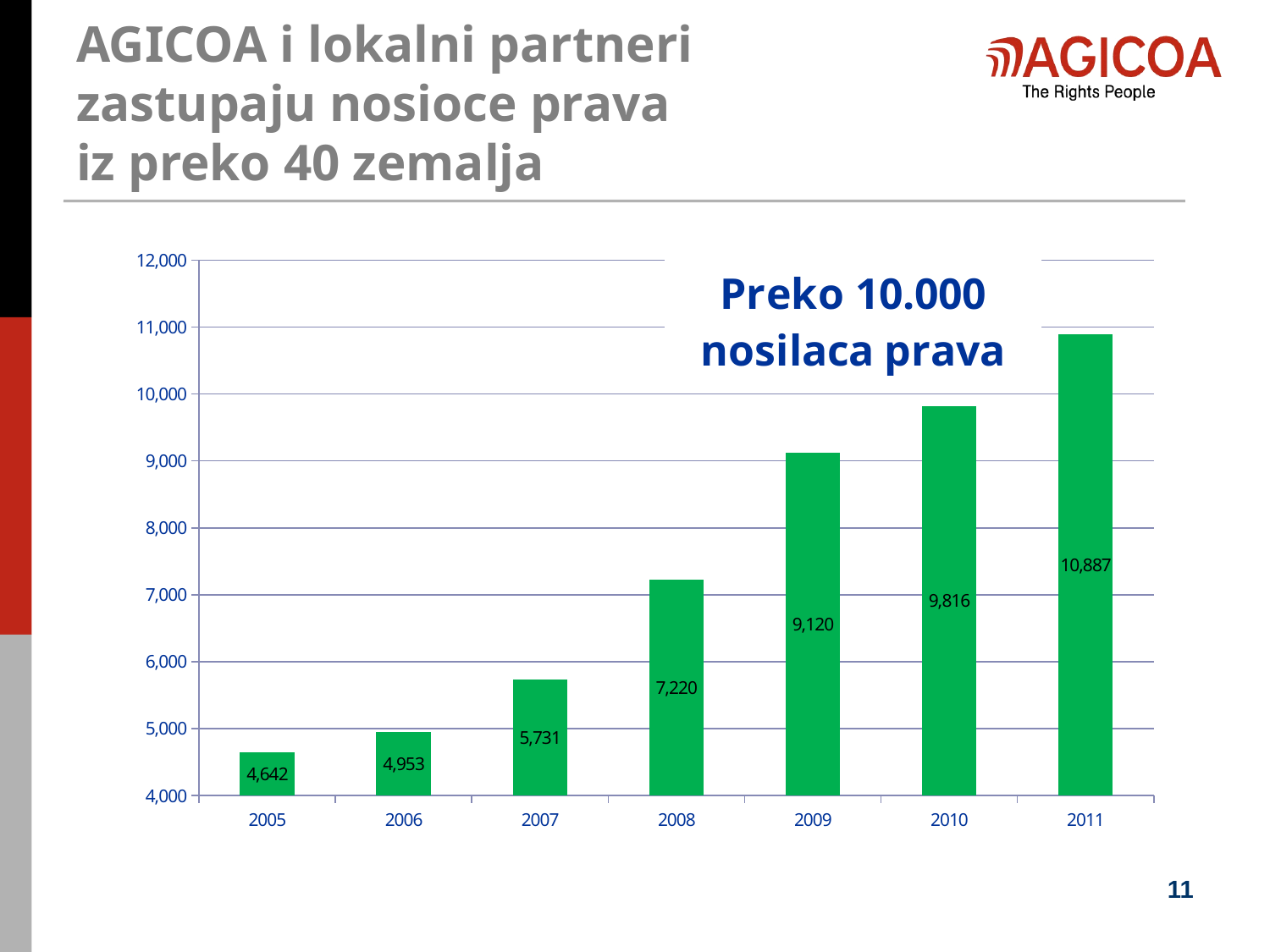
What is the value for 2005? 4,642 Which year has the highest value? 2011 What is the value for 2011? 10,887 What is the difference between the values for 2006 and 2005? 311 What is the value for 2008? 7,220 How many years are shown on the x axis? 7 Which year has the lowest value? 2005 Is the value for 2010 greater or less than 10,000? less What kind of chart is shown on the slide? bar chart Which is larger, the value for 2009 or the value for 2008? 2009 Do the values rise or fall from 2005 to 2011? rise What is the difference between the values for 2011 and 2010? 1,071